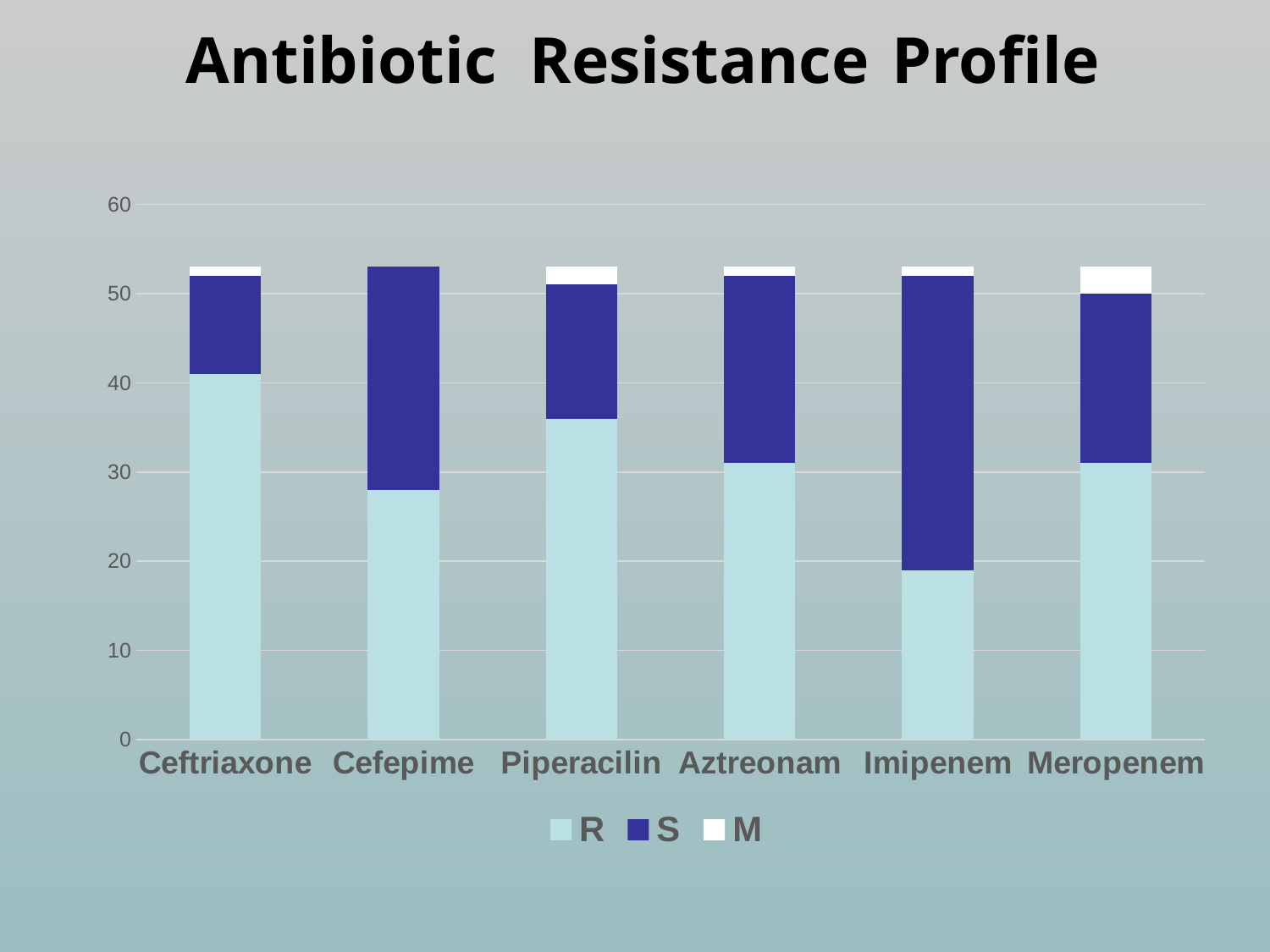
What kind of chart is shown on the slide? stacked bar chart How many series does the legend list? 3 Is the R value for Imipenem greater or less than 30? less Which antibiotic has the largest R segment? Ceftriaxone How many antibiotics are shown on the x axis? 6 Which has the larger R segment, Ceftriaxone or Cefepime? Ceftriaxone Which has the larger S segment, Imipenem or Aztreonam? Imipenem What is the title of the chart? Antibiotic Resistance Profile Which antibiotic has the smallest R segment? Imipenem Which antibiotic has the largest S segment? Imipenem Which series is shown in light blue in the legend? R Is the R value for Piperacilin greater or less than 30? greater